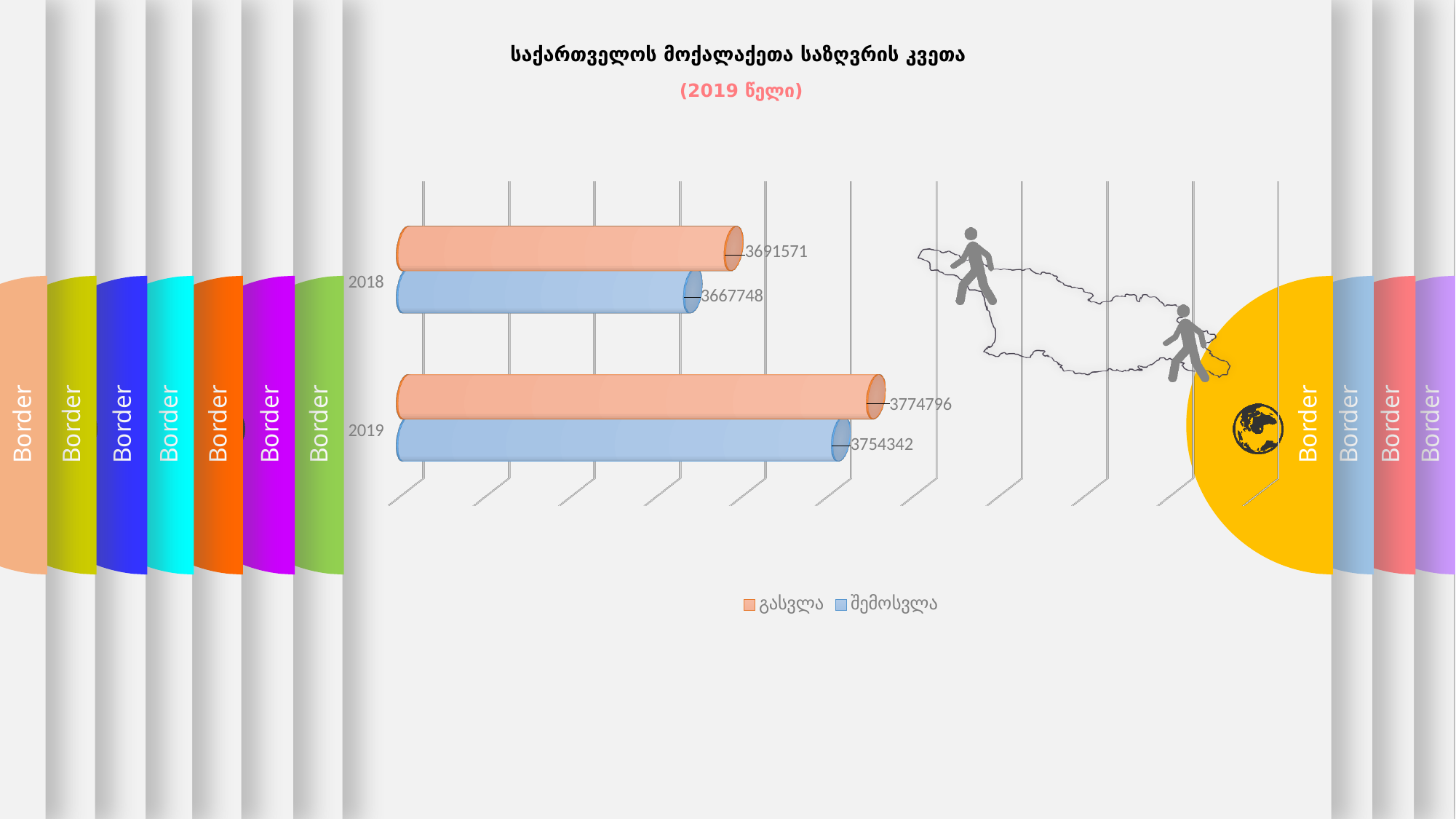
What is the value of შემოსვლა for 2019? 3754342 How many years (categories) are shown in the chart? 2 What is the difference between გასვლა and შემოსვლა in 2019? 20454 What is the value of შემოსვლა for 2018? 3667748 What is the value of გასვლა for 2018? 3691571 Which year has the lower შემოსვლა value? 2018 What kind of chart is shown on the slide? Bar chart In 2018, which is larger: გასვლა or შემოსვლა? გასვლა What is the value of გასვლა for 2019? 3774796 What is the difference between the გასვლა values for 2019 and 2018? 83225 Which year has the higher გასვლა value? 2019 How many series does the legend list? 2